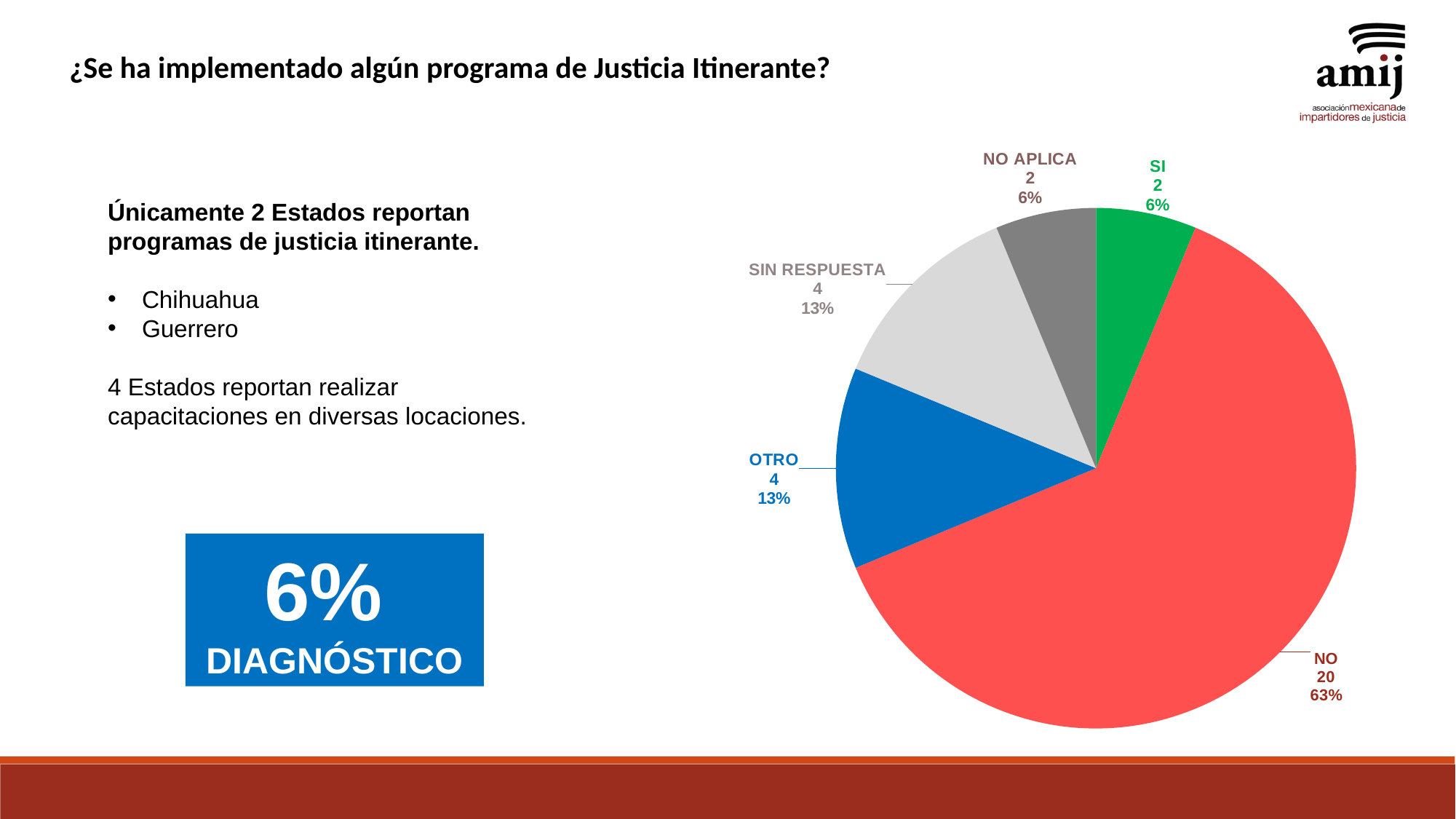
What type of chart is shown on the slide? pie chart How many slices does the pie chart have? 5 What percentage share does the NO slice have? 63% Which is larger, the SIN RESPUESTA count or the NO APLICA count? SIN RESPUESTA What is the total count across all slices of the pie chart? 32 What percentage share does the SIN RESPUESTA slice have? 13% What is the count for the NO slice? 20 What percentage share does the NO APLICA slice have? 6% What colour is the NO slice? red Which category has the largest slice? NO What is the count for the SI slice? 2 What is the difference between the NO count and the OTRO count? 16